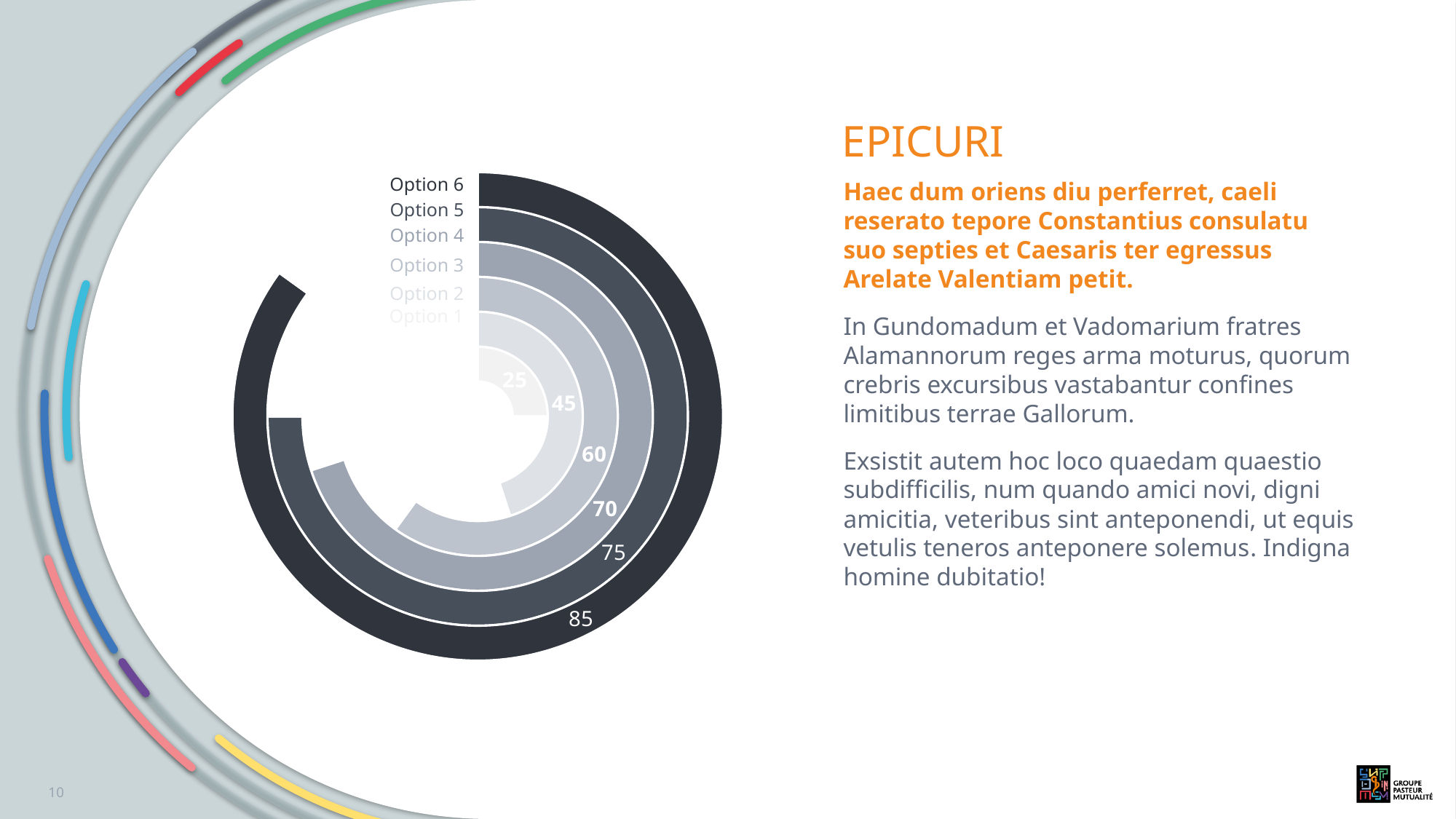
Which option has the highest value? Option 6 What is the value for Option 3? 60 What is the value for Option 1? 25 Which option has the lowest value? Option 1 What kind of chart is shown on the slide? radial bar chart What is the difference between the values for Option 4 and Option 2? 25 What is the difference between the values for Option 6 and Option 1? 60 What is the value for Option 6? 85 How many options are plotted in the chart? 6 Which is larger, the value for Option 4 or the value for Option 2? Option 4 What is the value for Option 5? 75 Do the values rise or fall from Option 1 to Option 6? rise